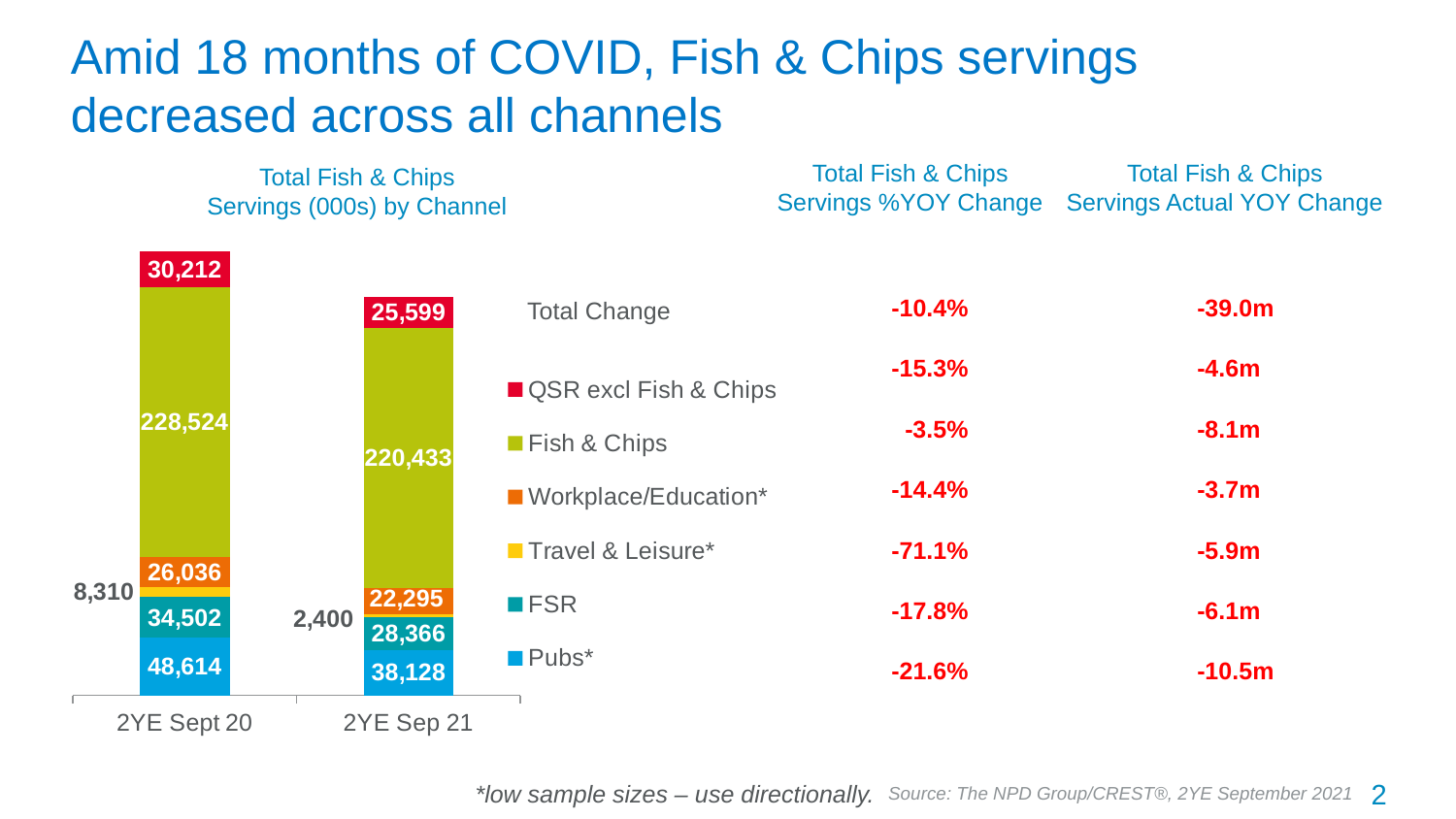
What is the value for Pubs* in 2YE Sep 21? 38,128 What is the value for Travel & Leisure* in 2YE Sep 21? 2,400 Which channel has the largest segment in the 2YE Sep 21 bar? Fish & Chips Which is larger, FSR in 2YE Sept 20 or FSR in 2YE Sep 21? FSR in 2YE Sept 20 What is the value for QSR excl Fish & Chips in 2YE Sept 20? 30,212 What is the difference between the Fish & Chips values for 2YE Sept 20 and 2YE Sep 21? 8,091 How many series does the chart legend list? 6 How many bars (time periods) are plotted on the x axis? 2 What is the value for Fish & Chips in 2YE Sept 20? 228,524 What type of chart is shown on the slide? stacked bar chart What is the total of the 2YE Sep 21 stacked bar? 337,221 Which channel has the smallest segment in the 2YE Sept 20 bar? Travel & Leisure*